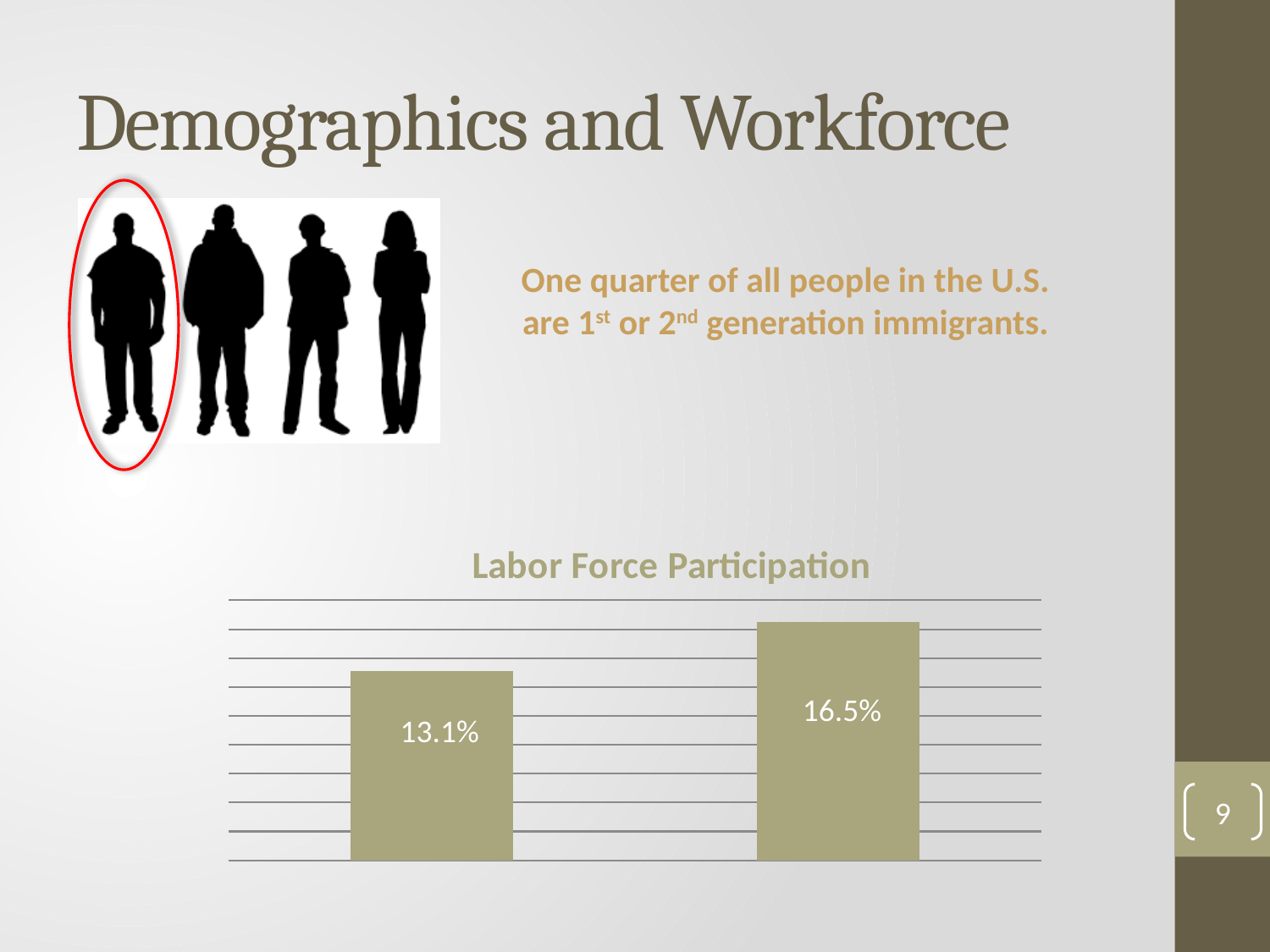
What is the highest value printed on the Labor Force Participation chart? 16.5% Do the values in the Labor Force Participation chart rise or fall from left to right? rise What kind of chart is shown under the heading Labor Force Participation? bar chart Which bar in the Labor Force Participation chart has the lower value, the left or the right? left How many bars are plotted in the Labor Force Participation chart? 2 What is the difference between the two values shown in the Labor Force Participation chart? 3.4% What is the value shown on the left bar of the Labor Force Participation chart? 13.1% What is the title of the chart on the slide? Labor Force Participation In the Labor Force Participation chart, is the value of the right bar larger or smaller than the value of the left bar? larger Which bar in the Labor Force Participation chart has the higher value, the left or the right? right What is the value shown on the right bar of the Labor Force Participation chart? 16.5%